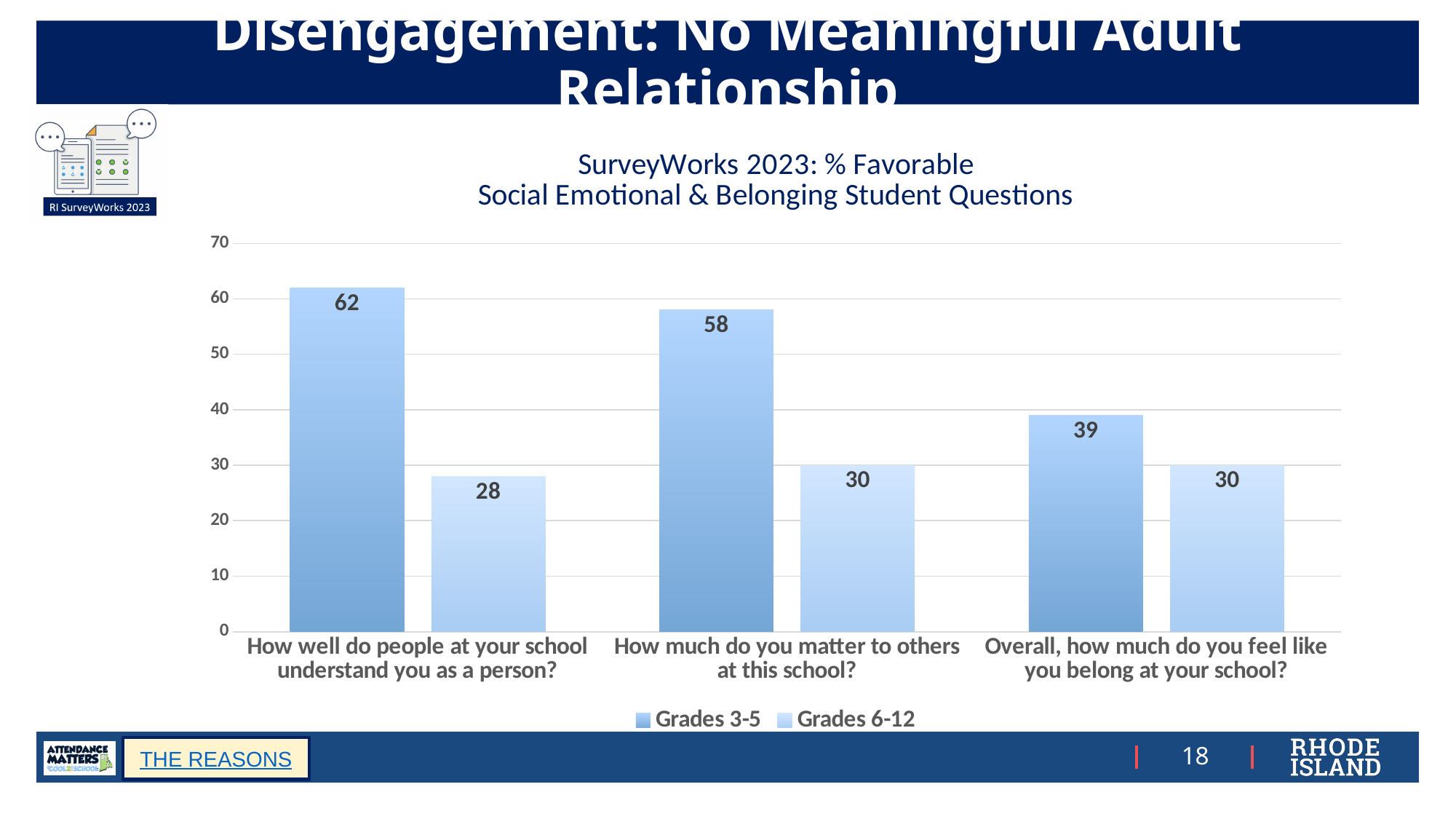
How many survey questions (categories) are shown on the x axis? 3 What kind of chart is shown on the slide? Bar chart What is the difference between the Grades 3-5 and Grades 6-12 values for "How well do people at your school understand you as a person?" 34 Which question has the lowest Grades 6-12 value? How well do people at your school understand you as a person? Which question has the highest Grades 3-5 value? How well do people at your school understand you as a person? How many series does the legend list? 2 Which is larger: the Grades 3-5 value for "How much do you matter to others at this school?" or the Grades 3-5 value for "Overall, how much do you feel like you belong at your school?" How much do you matter to others at this school? What is the Grades 3-5 value for "How well do people at your school understand you as a person?" 62 What is the difference between the Grades 3-5 and Grades 6-12 values for "Overall, how much do you feel like you belong at your school?" 9 What is the Grades 6-12 value for "How much do you matter to others at this school?" 30 What is the Grades 3-5 value for "Overall, how much do you feel like you belong at your school?" 39 What are the two series named in the legend? Grades 3-5 and Grades 6-12